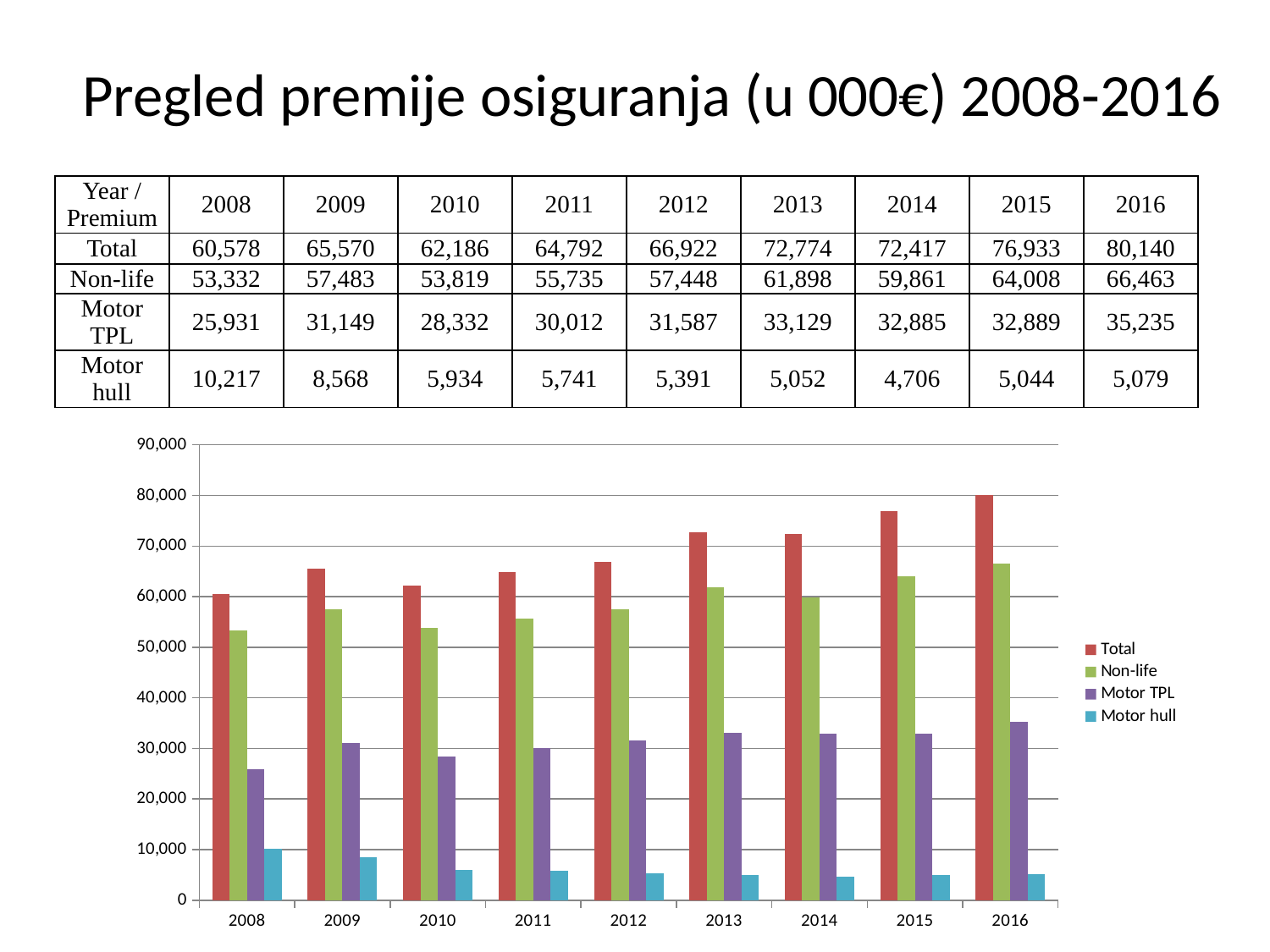
Is the Total value for 2013 greater or less than 70,000? greater Which year has the highest Total premium? 2016 Is the Non-life premium larger in 2015 or in 2014? 2015 What kind of chart is shown on the slide? bar chart How many series does the chart legend list? 4 Does the Motor hull series generally rise or fall from 2008 to 2014? fall What is the Motor hull premium value for 2008? 10,217 How many years are shown on the x axis of the chart? 9 What is the Total premium value for 2016? 80,140 What is the difference between the Total premium in 2016 and in 2008? 19,562 Which year has the lowest Motor hull premium? 2014 Which series is shown in red in the chart? Total